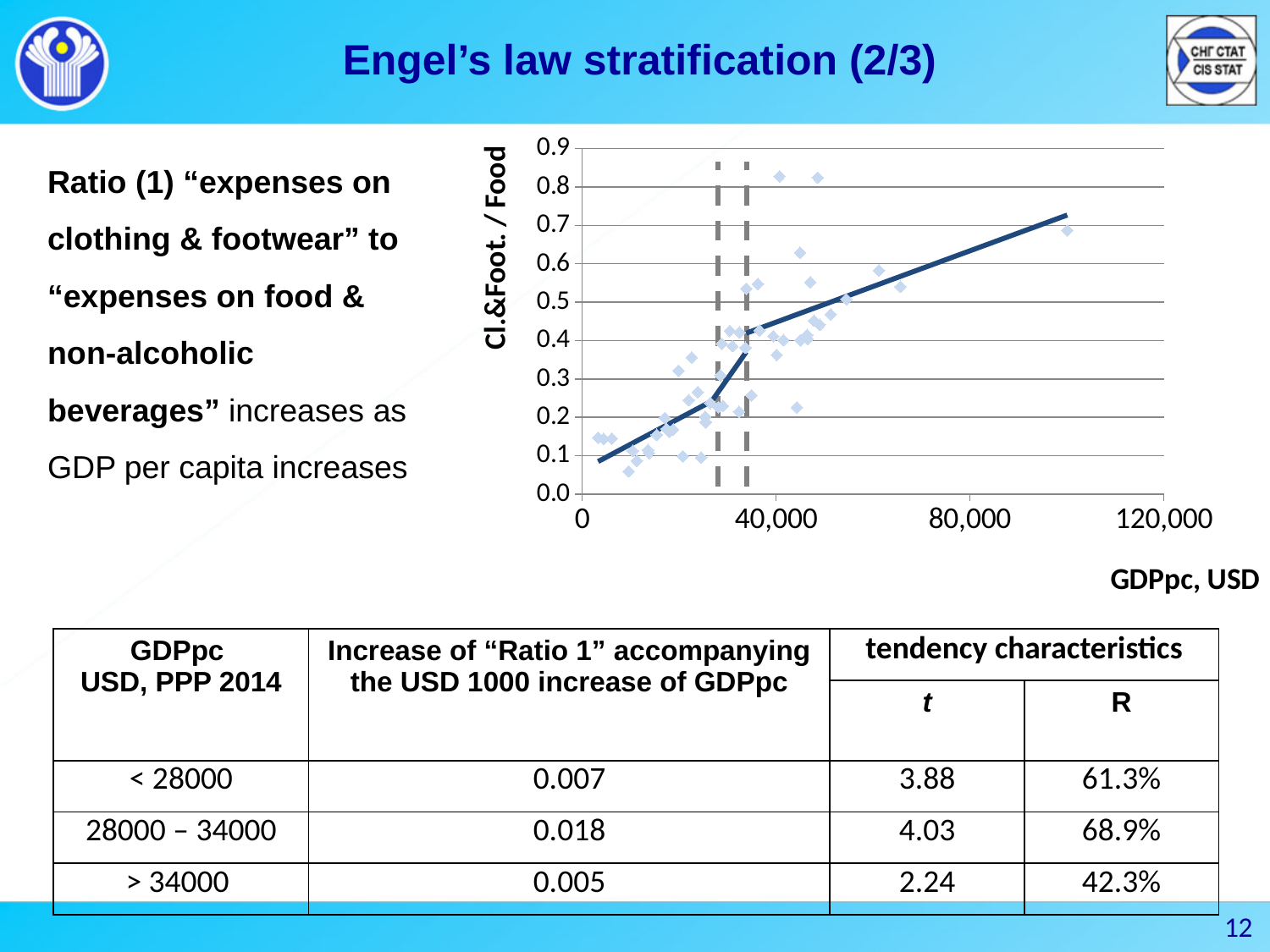
Is the ratio of the lowest plotted point on the chart greater or less than 0.1? less What kind of chart is shown on the slide? scatter chart What is the label of the vertical axis of the chart? Cl.&Foot. / Food What is the highest value shown on the horizontal axis of the chart? 120,000 What is the label of the horizontal axis of the chart? GDPpc, USD Does the ratio of clothing & footwear expenses to food expenses rise or fall as GDP per capita increases along the x axis? rise Is the ratio at the right-hand end of the trend line (near GDPpc 100,000) greater or less than 0.6? greater Are the two dashed vertical lines on the chart located to the left or to the right of the 40,000 tick on the horizontal axis? left